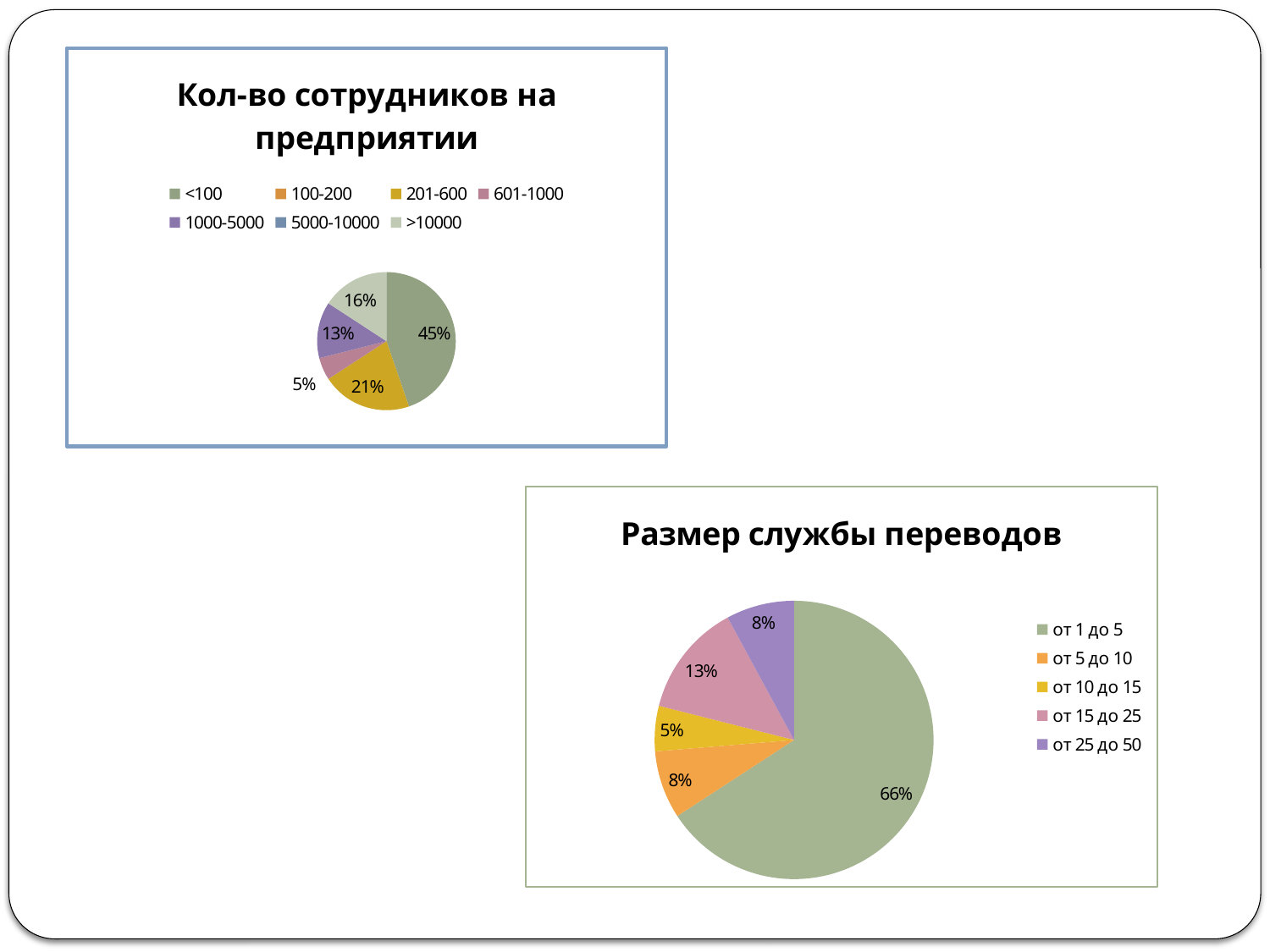
In the chart titled "Кол-во сотрудников на предприятии", what share is shown for the "201-600" category? 21% In the chart titled "Размер службы переводов", what share is shown for "от 1 до 5"? 66% What type of chart is "Размер службы переводов"? Pie chart In the chart titled "Размер службы переводов", which is larger: the share for "от 15 до 25" or the share for "от 25 до 50"? от 15 до 25 In the chart titled "Кол-во сотрудников на предприятии", what share is shown for the "<100" category? 45% In the chart titled "Размер службы переводов", how many categories does the legend list? 5 In the chart titled "Размер службы переводов", which category has the smallest slice? от 10 до 15 In the chart titled "Размер службы переводов", what share is shown for "от 15 до 25"? 13% In the chart titled "Кол-во сотрудников на предприятии", which category has the largest slice? <100 In the chart titled "Кол-во сотрудников на предприятии", what share is shown for the ">10000" category? 16% In the chart titled "Кол-во сотрудников на предприятии", what is the difference between the "<100" share and the "201-600" share? 24% In the chart titled "Кол-во сотрудников на предприятии", how many entries does the legend list? 7